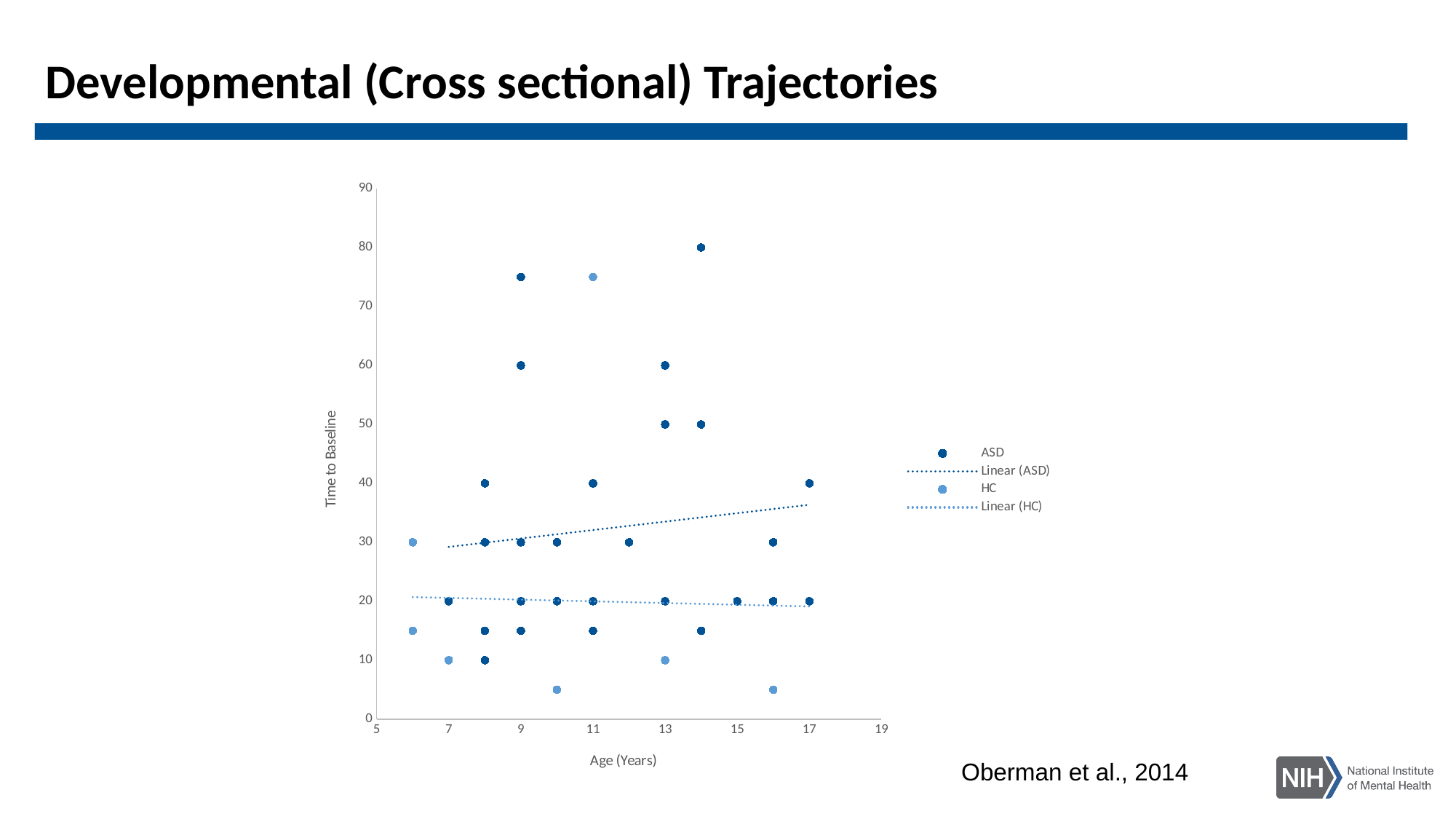
At what age does the highest ASD point occur? 14 Which series contains the single highest plotted point, ASD or HC? ASD Is the highest HC point at age 11 greater or less than 70? greater What is the title of the y axis? Time to Baseline What kind of chart is shown on the slide? scatter chart Is the HC point at age 10 greater or less than 10? less Is the highest ASD point at age 14 greater or less than 70? greater Does the Linear (HC) trendline rise or fall as age increases? fall What is the title of the x axis? Age (Years) How many entries does the legend list? 4 Does the Linear (ASD) trendline rise or fall as age increases? rise